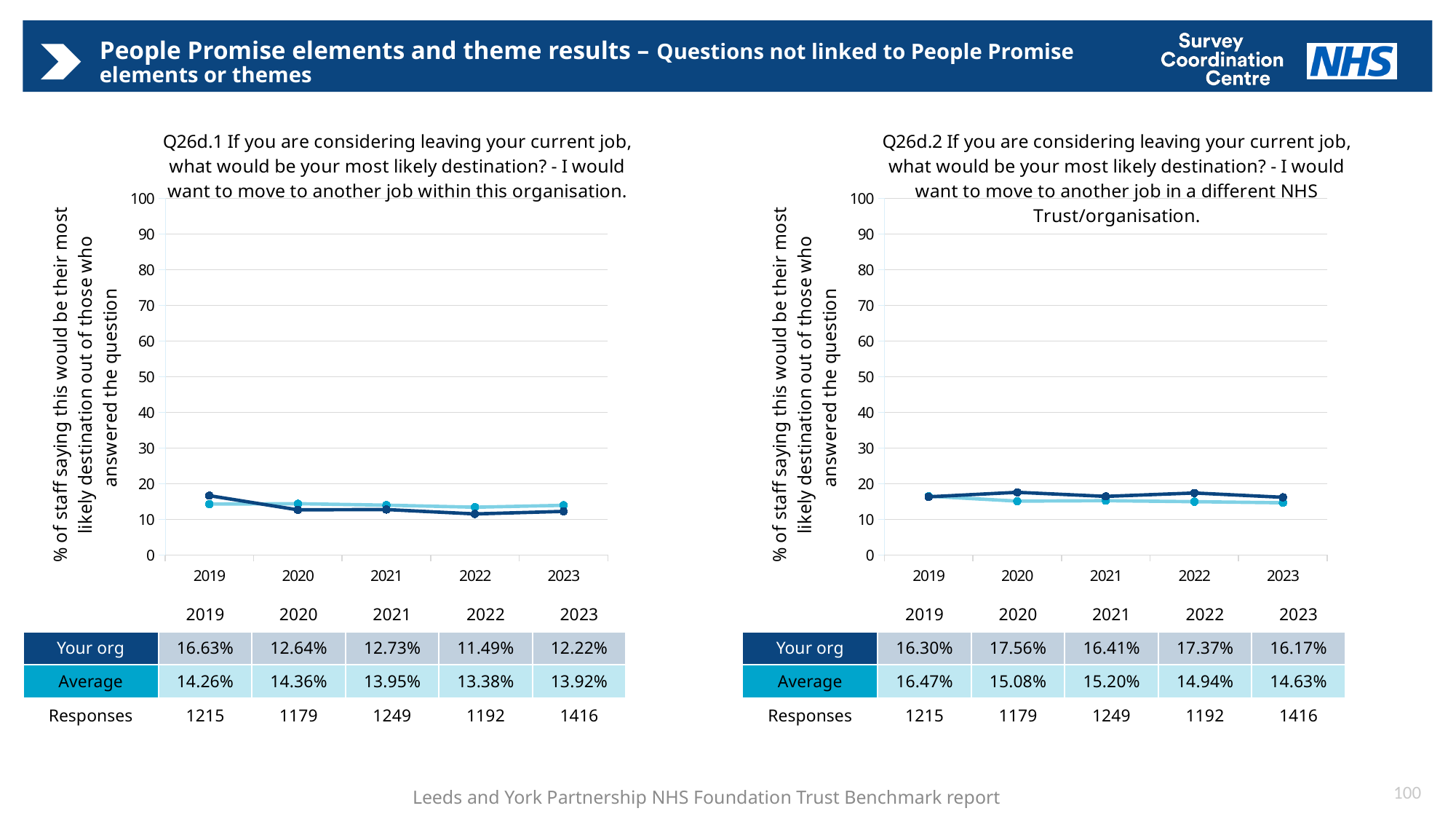
In the Q26d.1 chart (left), which year has the highest Your org value? 2019 In the Q26d.1 chart (left), what is the difference between the Your org and Average values for 2023? 1.70% In the Q26d.2 chart (right), which year has the highest Your org value? 2020 In the Q26d.1 chart (left), which year has the lowest Your org value? 2022 How many years are plotted on the x axis of the Q26d.1 chart (left)? 5 In the Q26d.1 chart (left), what is the Your org value for 2019? 16.63% In the Q26d.2 chart (right), what is the Average value for 2023? 14.63% What kind of chart is the Q26d.2 chart (right)? Line chart In the Q26d.2 chart (right), what is the Your org value for 2020? 17.56% In the Q26d.1 chart (left), what is the Average value for 2022? 13.38% In the Q26d.2 chart (right), which is larger in 2022, Your org or Average? Your org In the Q26d.2 chart (right), is the Your org value for 2021 greater or less than 20? less